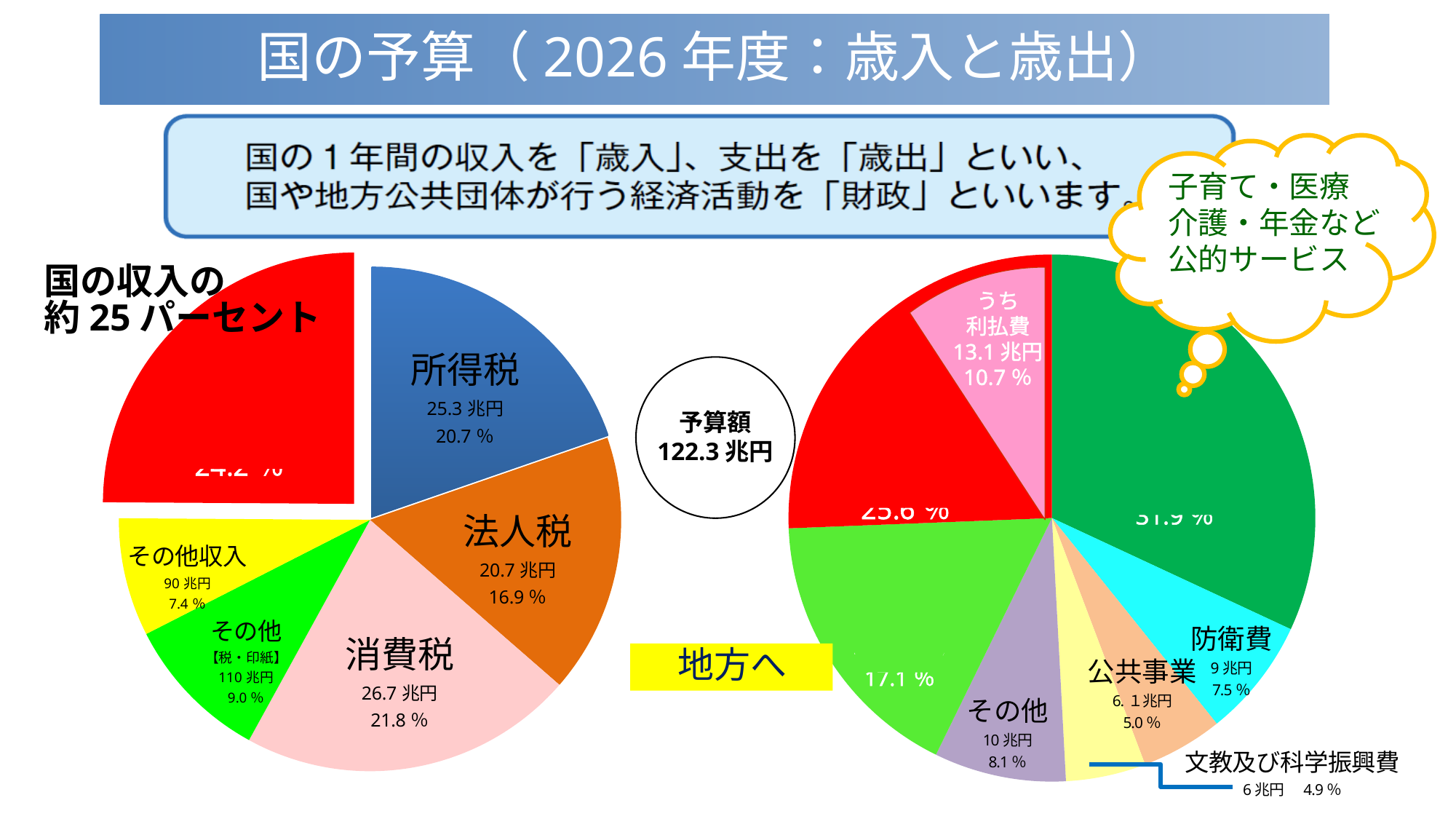
In the left pie chart (revenue), which is larger, 消費税 or 法人税? 消費税 In the left pie chart (revenue), what is the difference in 兆円 between 所得税 and 法人税? 4.6 兆円 In the left pie chart (revenue), what percentage share does 所得税 have? 20.7 % In the right pie chart (expenditure), what is the value for 文教及び科学振興費? 6 兆円 In the left pie chart (revenue), what percentage share does その他収入 have? 7.4 % In the right pie chart (expenditure), what is the value for 防衛費? 9 兆円 What kind of charts are shown on the slide? Pie charts In the right pie chart (expenditure), what percentage share does 公共事業 have? 5.0 % In the left pie chart (revenue), what is the value for 消費税? 26.7 兆円 What total budget amount (予算額) is shown in the circle between the two pie charts? 122.3 兆円 In the right pie chart (expenditure), which is larger, 防衛費 or 公共事業? 防衛費 In the left pie chart (revenue), what is the value for 法人税? 20.7 兆円